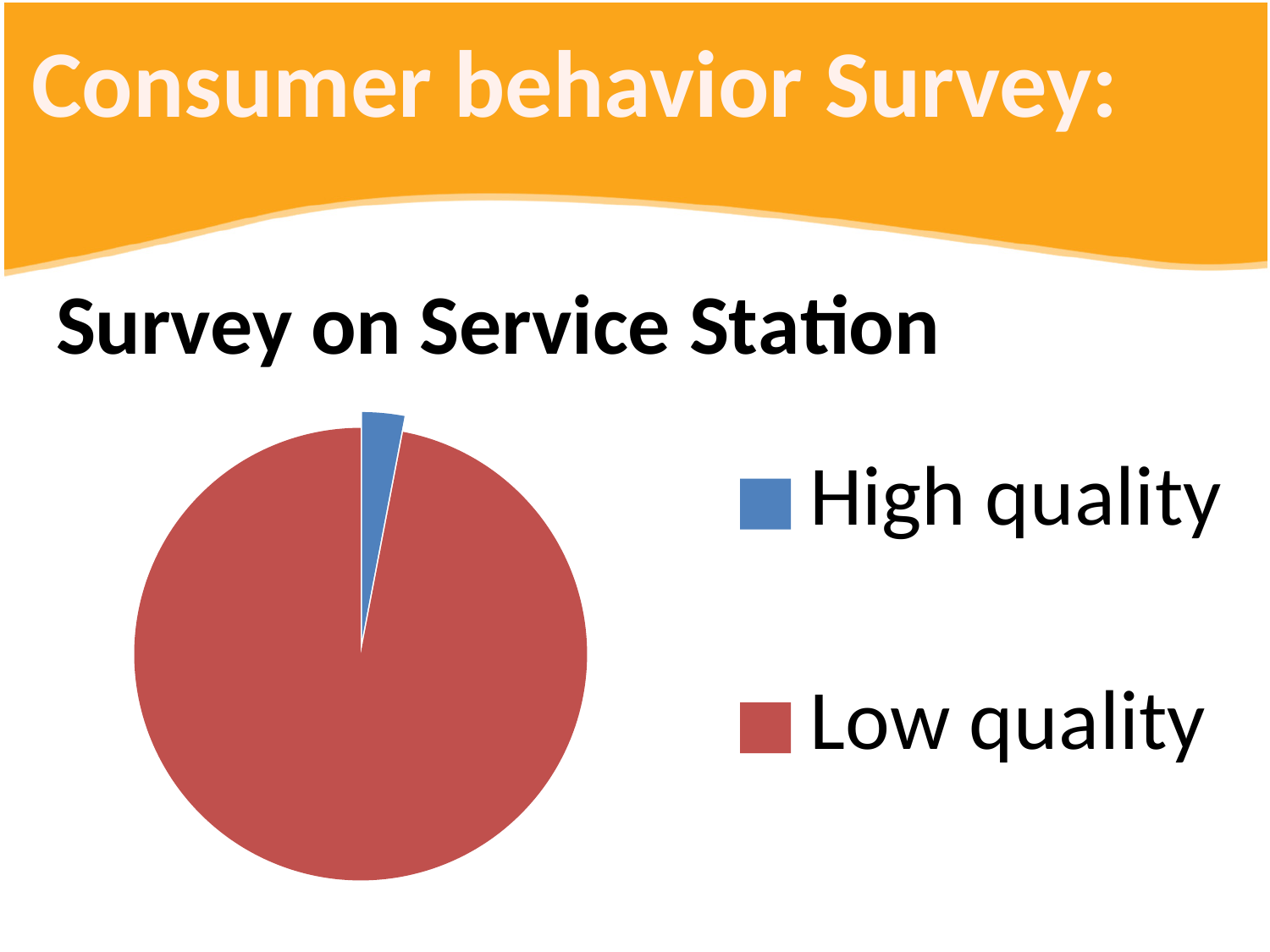
Which category has the largest slice of the pie? Low quality What kind of chart is shown on the slide? pie chart How many entries does the legend list? 2 Which is larger, the High quality slice or the Low quality slice? Low quality How many slices does the pie chart have? 2 Which category has the smallest slice of the pie? High quality What colour is the Low quality slice? red What is the title of the chart? Survey on Service Station